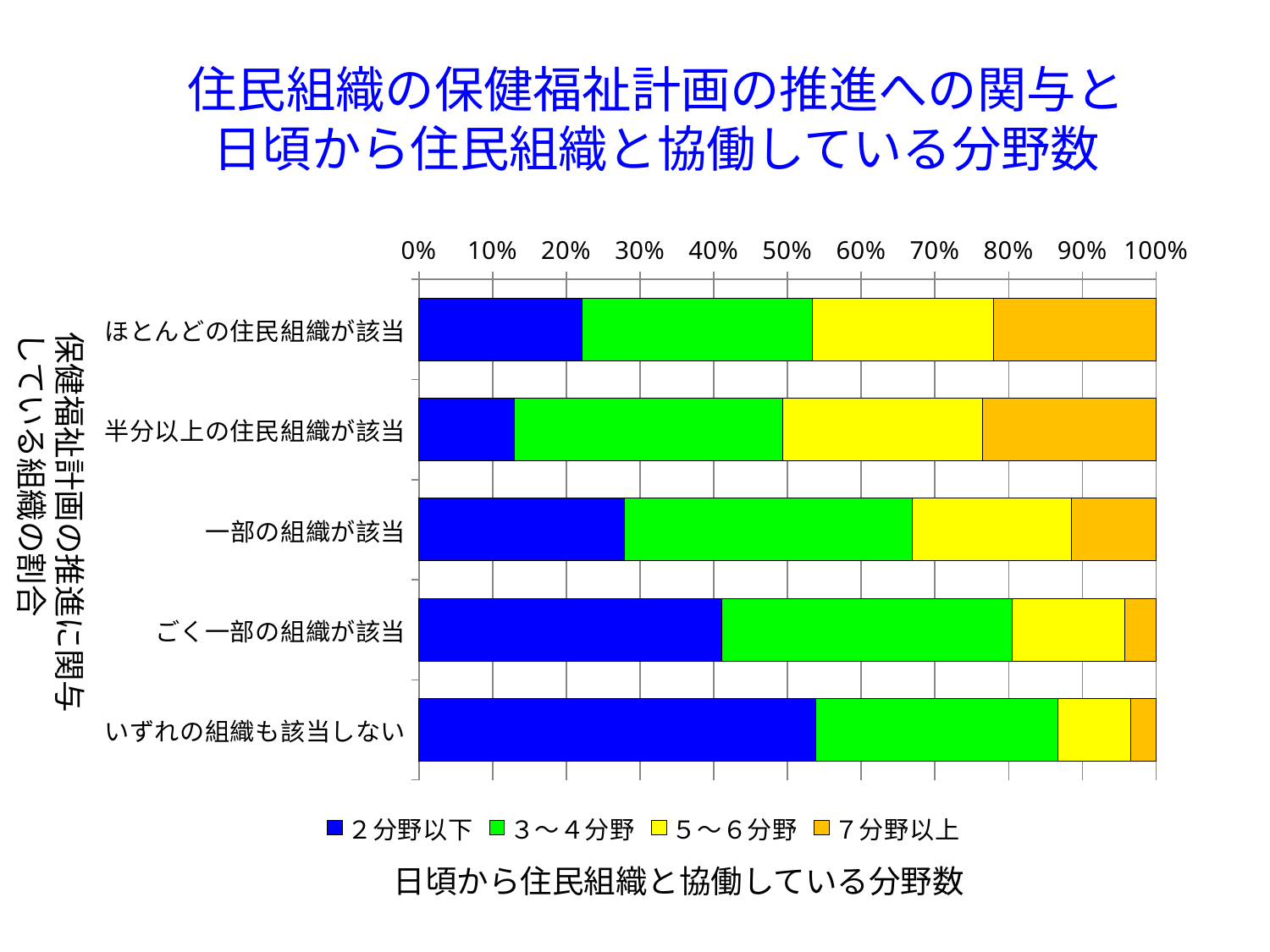
How many series does the legend list? 4 Which has the larger 2分野以下 share: ごく一部の組織が該当 or 一部の組織が該当? ごく一部の組織が該当 How many categories are shown on the vertical axis of the chart? 5 Is the 2分野以下 share for 半分以上の住民組織が該当 greater or less than 20%? less What kind of chart is shown on the slide? stacked bar chart What value does each stacked bar total on the horizontal axis? 100% Is the 2分野以下 share for ほとんどの住民組織が該当 greater or less than 30%? less Which category has the smallest segment for 2分野以下? 半分以上の住民組織が該当 Is the 2分野以下 share for いずれの組織も該当しない greater or less than 40%? greater What are the four legend entries of the chart? 2分野以下, 3～4分野, 5～6分野, 7分野以上 Which category has the largest segment for 2分野以下? いずれの組織も該当しない